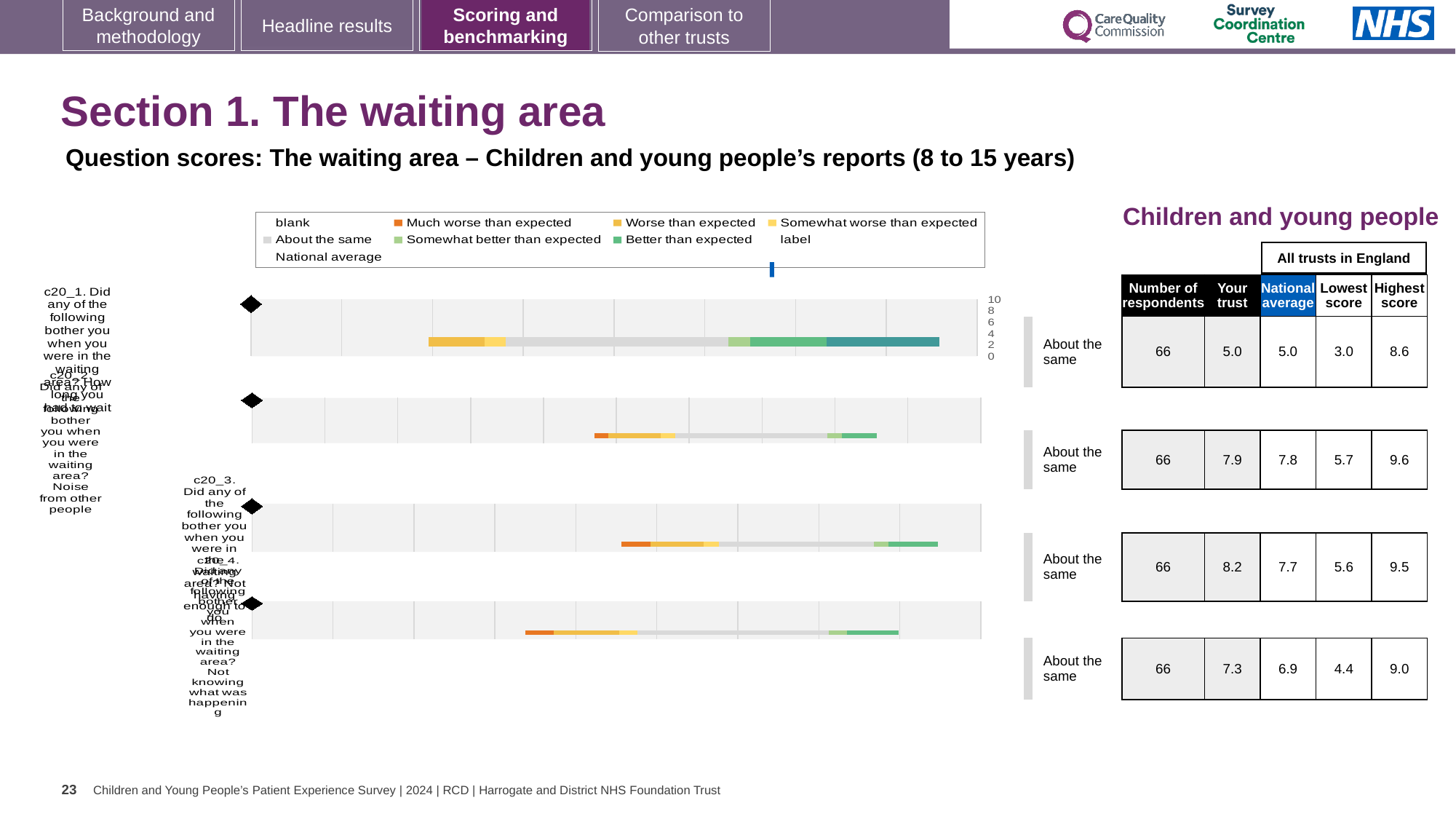
How many questions (bars) are plotted in the waiting area chart? 4 How many respondents are shown for each of the waiting area questions? 66 What kind of chart is used to show the question scores for the waiting area? Bar chart For c20_2, which is larger: the 'Your trust' score or the national average? Your trust What is the 'Your trust' score for c20_2 (Noise from other people)? 7.9 What benchmark category is shown next to each of the four waiting area questions? About the same For c20_3, what is the difference between the 'Your trust' score and the national average? 0.5 How many entries does the legend of the waiting area chart list? 9 For c20_2, what is the difference between the highest score and the lowest score across all trusts in England? 3.9 Which question has the highest 'Your trust' score? c20_3 (Not having enough to do) What is the national average score for c20_4 (Not knowing what was happening)? 6.9 Which question has the lowest 'Your trust' score? c20_1 (How long you had to wait)